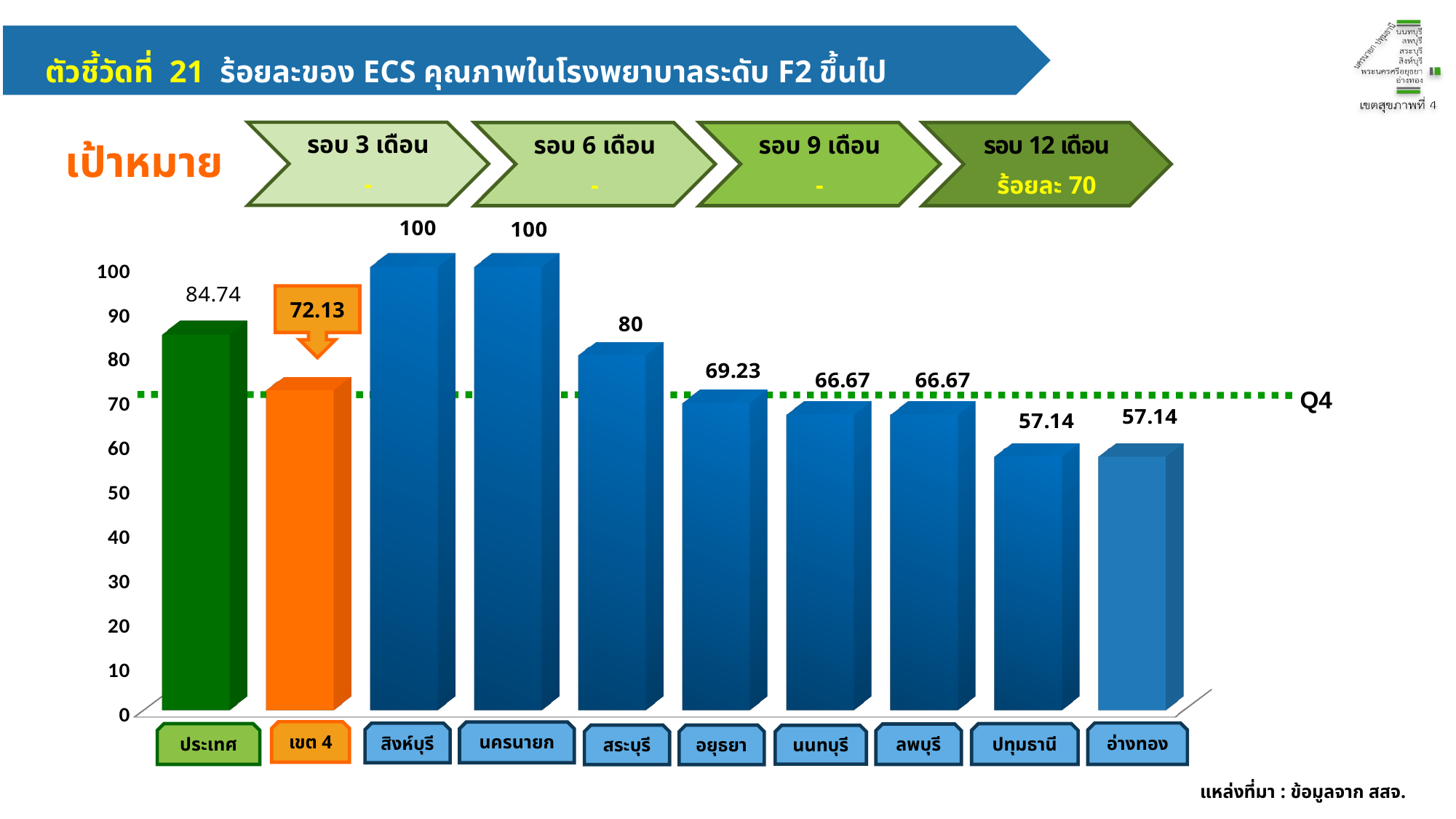
Which is larger, the value for สระบุรี or the value for อยุธยา? สระบุรี What is the value shown for เขต 4? 72.13 What is the lowest value shown on the chart? 57.14 Which two provinces have the highest value of 100? สิงห์บุรี and นครนายก What type of chart is shown on the slide? bar chart What is the value shown for ประเทศ? 84.74 Is the value for นนทบุรี greater or less than 70? less What is the value shown for สระบุรี? 80 How many bars are shown on the chart? 10 What is the value shown for อยุธยา? 69.23 What is the value shown for ปทุมธานี? 57.14 What is the difference between the values for ประเทศ and เขต 4? 12.61